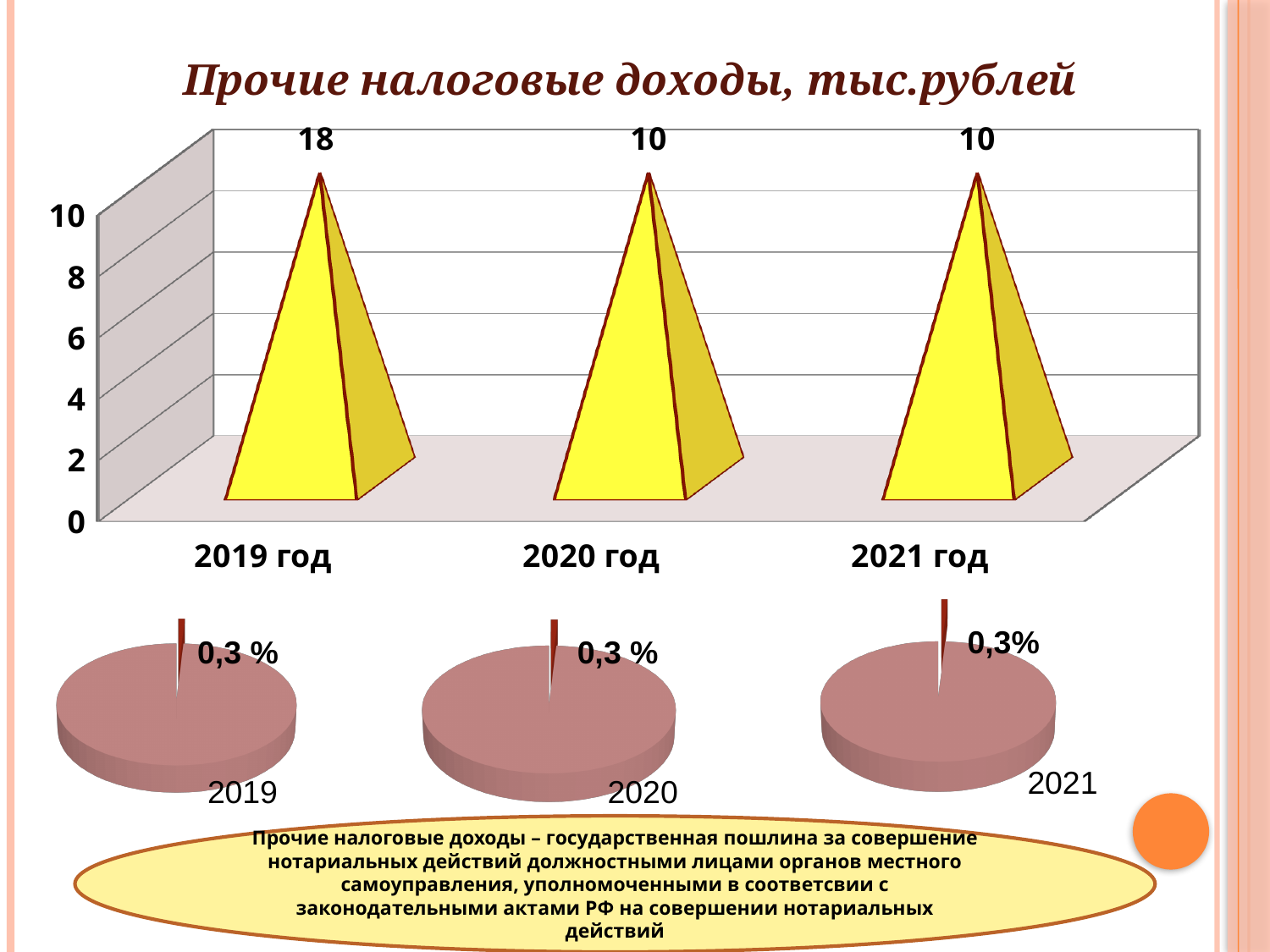
In the bar chart 'Прочие налоговые доходы, тыс.рублей', what is the value for 2020 год? 10 In the pie chart labelled 2019 at the bottom left of the slide, what share is shown for the small slice? 0,3 % In the bar chart 'Прочие налоговые доходы, тыс.рублей', which year has the highest value? 2019 год In the bar chart 'Прочие налоговые доходы, тыс.рублей', what is the value for 2021 год? 10 In the bar chart 'Прочие налоговые доходы, тыс.рублей', what is the value for 2019 год? 18 In the bar chart 'Прочие налоговые доходы, тыс.рублей', does the value rise or fall from 2019 год to 2020 год? fall What kind of chart is the top chart titled 'Прочие налоговые доходы, тыс.рублей'? bar chart In the bar chart 'Прочие налоговые доходы, тыс.рублей', which is larger, the value for 2019 год or the value for 2021 год? 2019 год In the pie chart labelled 2021 at the bottom right of the slide, what share is shown for the small slice? 0,3% How many categories (years) are shown in the bar chart 'Прочие налоговые доходы, тыс.рублей'? 3 What is the title of the bar chart at the top of the slide? Прочие налоговые доходы, тыс.рублей In the bar chart 'Прочие налоговые доходы, тыс.рублей', what is the difference between the values for 2019 год and 2020 год? 8